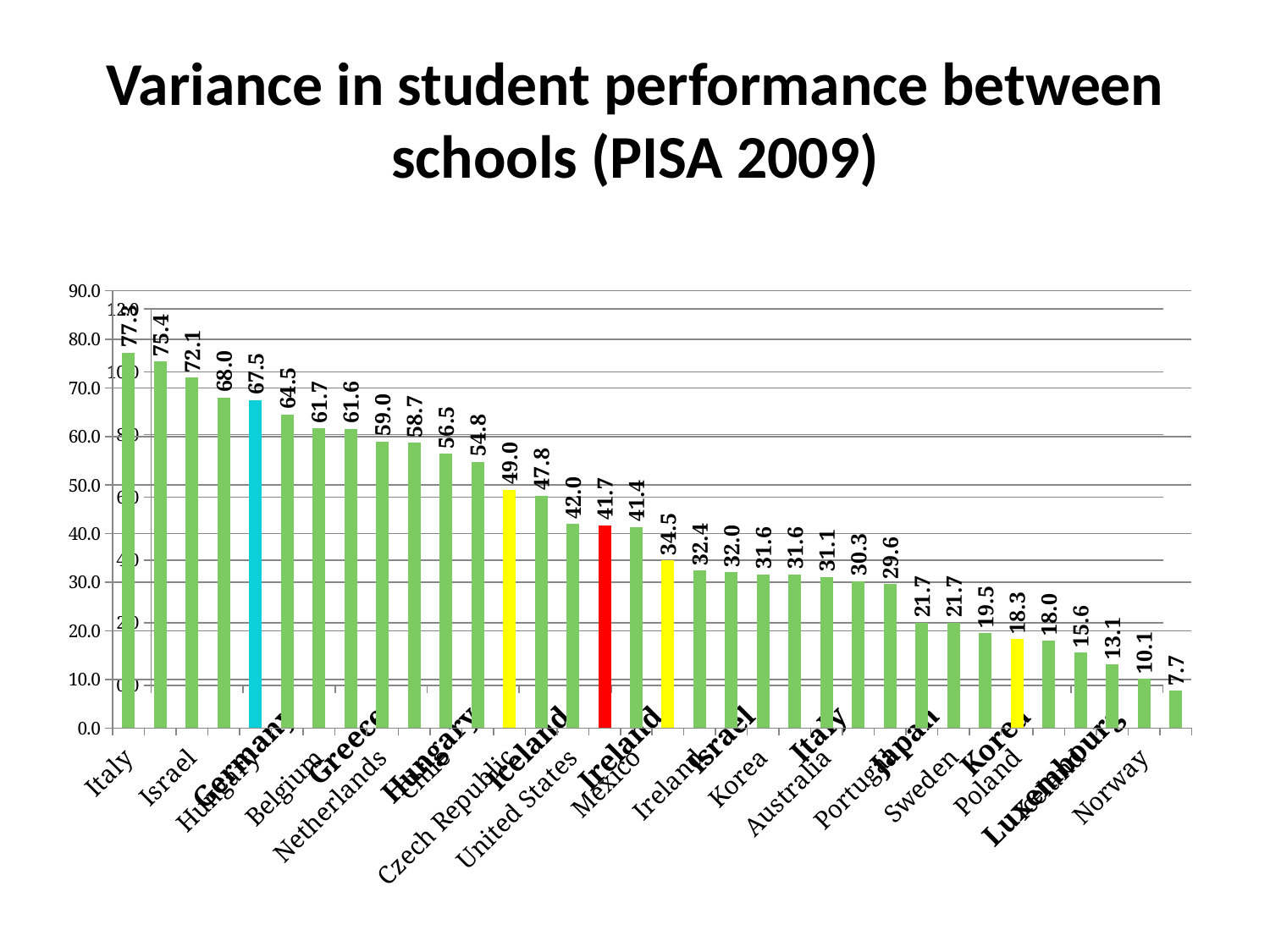
What is the lowest value shown on the chart? 7.7 What value is labelled on the red bar? 41.7 What is the value for Italy, the first bar on the left? 77.3 What is the difference between the highest value (77.8) and the lowest value (7.7)? 69.6 What is the title of the chart? Variance in student performance between schools (PISA 2009) What is the difference between the cyan bar (67.5) and the red bar (41.7)? 25.8 What is the highest value shown on the chart? 77.3 How many bars are plotted on the chart? 34 What kind of chart is shown on the slide? bar chart What value is labelled on the cyan (light blue) bar? 67.5 Do the bar values rise or fall from left to right across the chart? fall